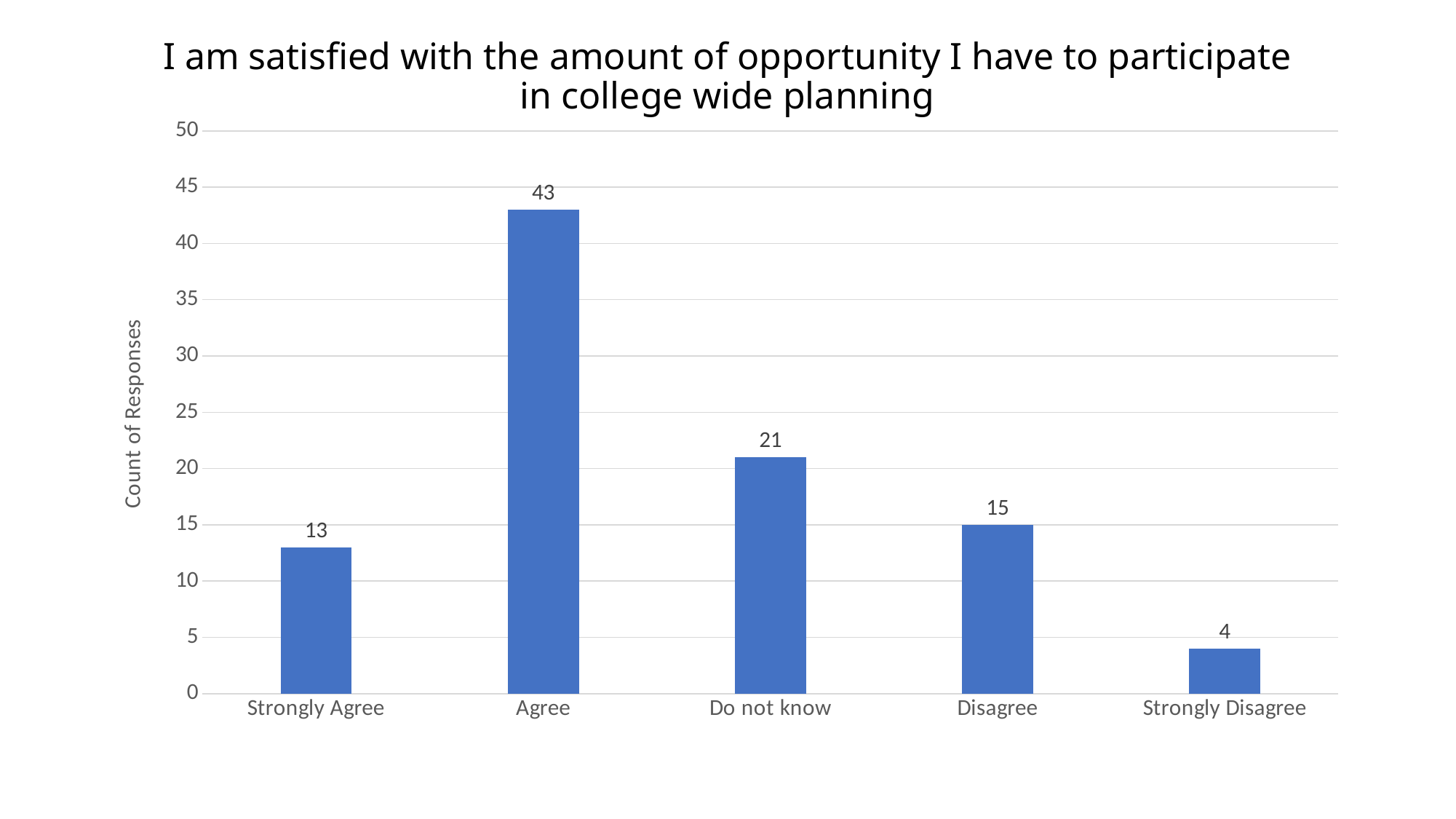
Which response category has the lowest count? Strongly Disagree Which has a higher count, Strongly Agree or Disagree? Disagree What is the count of responses for Do not know? 21 What kind of chart is shown on the slide? Bar chart What is the count of responses for Strongly Disagree? 4 What is the difference between the counts for Disagree and Strongly Agree? 2 What is the label of the vertical axis? Count of Responses What is the difference between the counts for Agree and Do not know? 22 What is the count of responses for Agree? 43 Which response category has the highest count? Agree Is the value for Do not know greater or less than 20? greater How many response categories are shown on the x axis? 5